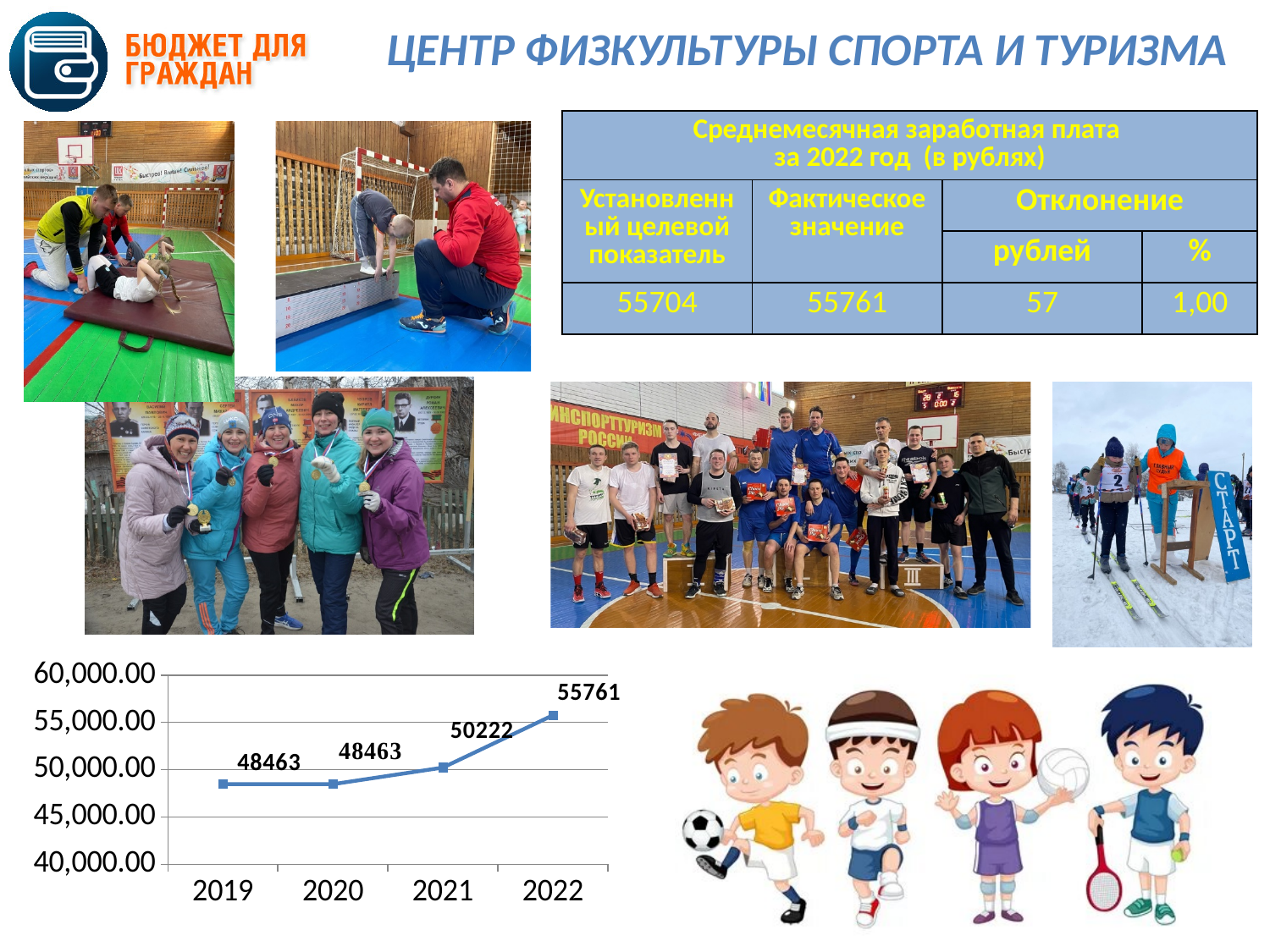
What is the difference between the 2022 and 2021 values in the line chart? 5539 What is the value plotted for 2022 in the line chart? 55761 How many data points are plotted in the line chart? 4 Which year has the highest value in the line chart? 2022 What is the value plotted for 2021 in the line chart? 50222 In the line chart, is the value for 2022 larger than the value for 2020? yes Is the value for 2021 in the line chart greater or less than 55,000.00? less What is the difference between the 2021 and 2020 values in the line chart? 1759 Do the values in the line chart rise or fall from 2019 to 2022? rise What type of chart is shown at the bottom left of the slide? line chart What is the lowest value shown on the vertical axis of the line chart? 40,000.00 What is the value plotted for 2019 in the line chart? 48463